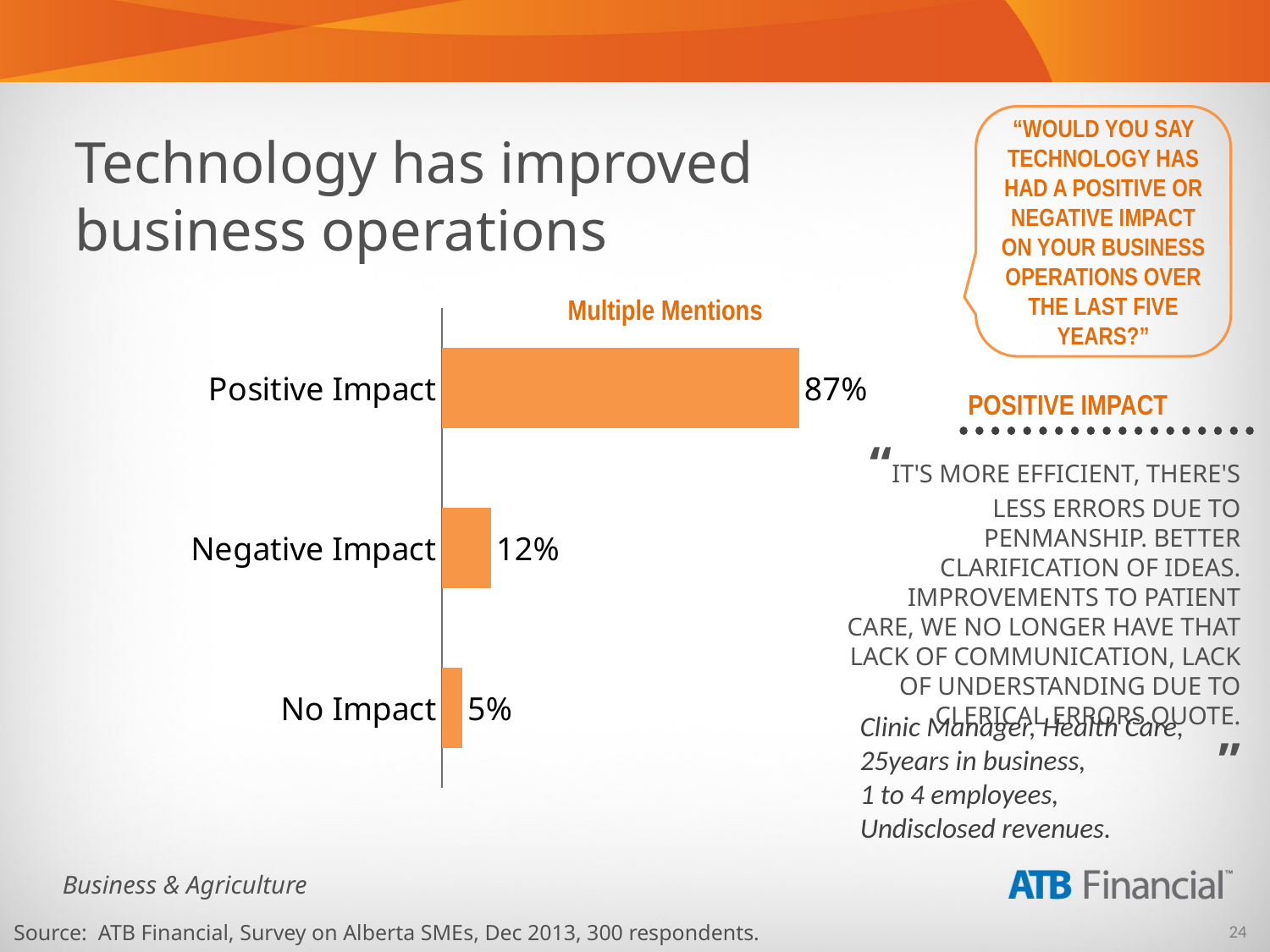
What is the value for No Impact? 5% How many categories are shown in the chart? 3 What is the difference between the values for Positive Impact and Negative Impact? 75% What is the difference between the values for Negative Impact and No Impact? 7% What label appears above the bars in the chart? Multiple Mentions Which is larger, the value for Negative Impact or the value for No Impact? Negative Impact What kind of chart is shown on the slide? Bar chart What is the value for Negative Impact? 12% Which category has the highest value? Positive Impact Which category has the lowest value? No Impact What is the value for Positive Impact? 87% What colour are the bars in the chart? Orange